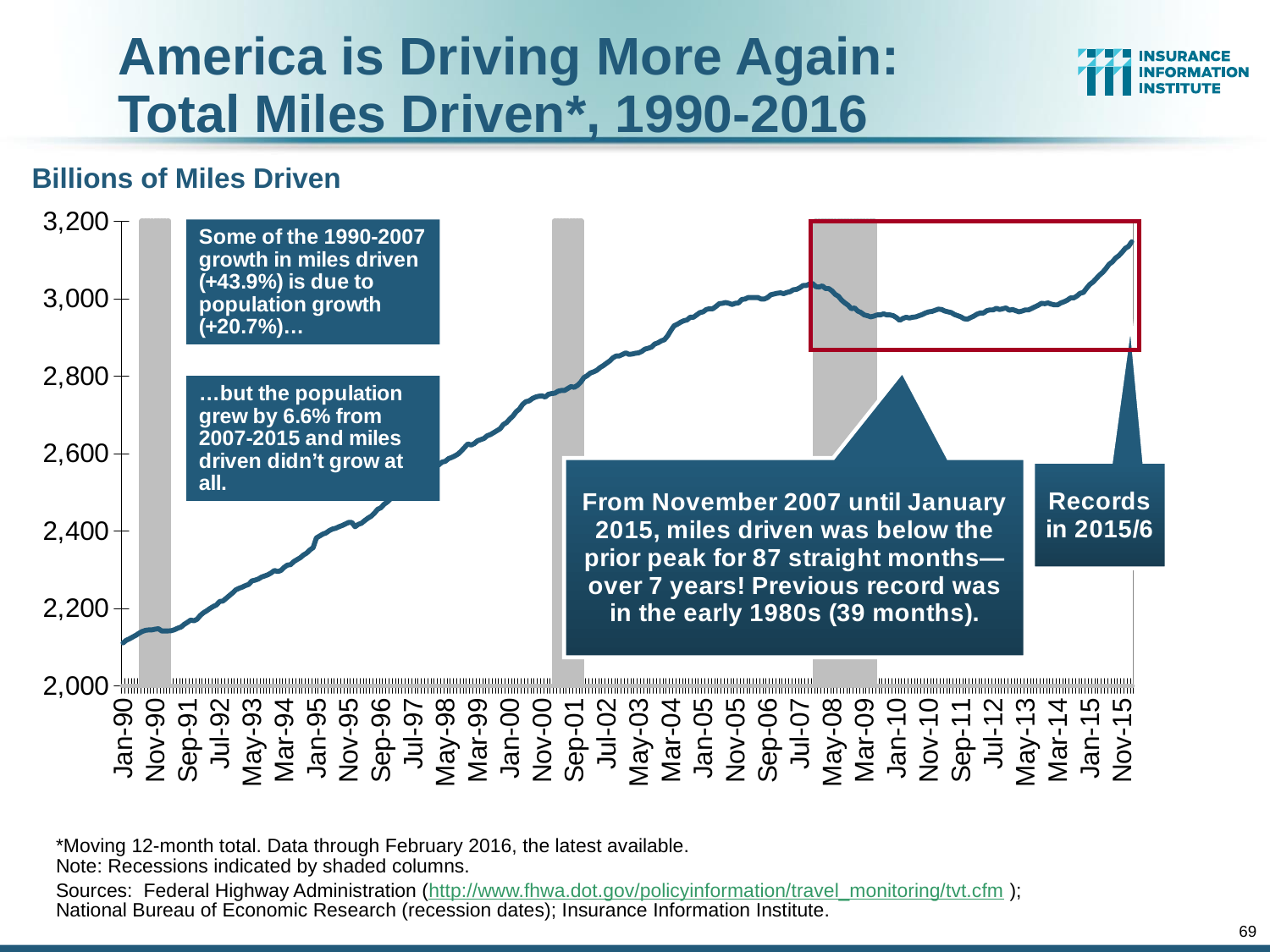
Which is larger, the value for Jan-10 or the value for Nov-15? Nov-15 Overall, do the values rise or fall from Jan-90 to Nov-15? Rise Is the value for Nov-15 greater or less than 3,000? greater What kind of chart is shown on the slide? Line chart At which end of the chart, Jan-90 or Nov-15, is the lowest value found? Jan-90 Is the value for Jan-90 greater or less than 2,200? less What unit is the y axis of the chart measured in? Billions of Miles Driven Is the value for Jan-00 greater or less than 2,600? greater What is the title of the chart on the slide? America is Driving More Again: Total Miles Driven*, 1990-2016